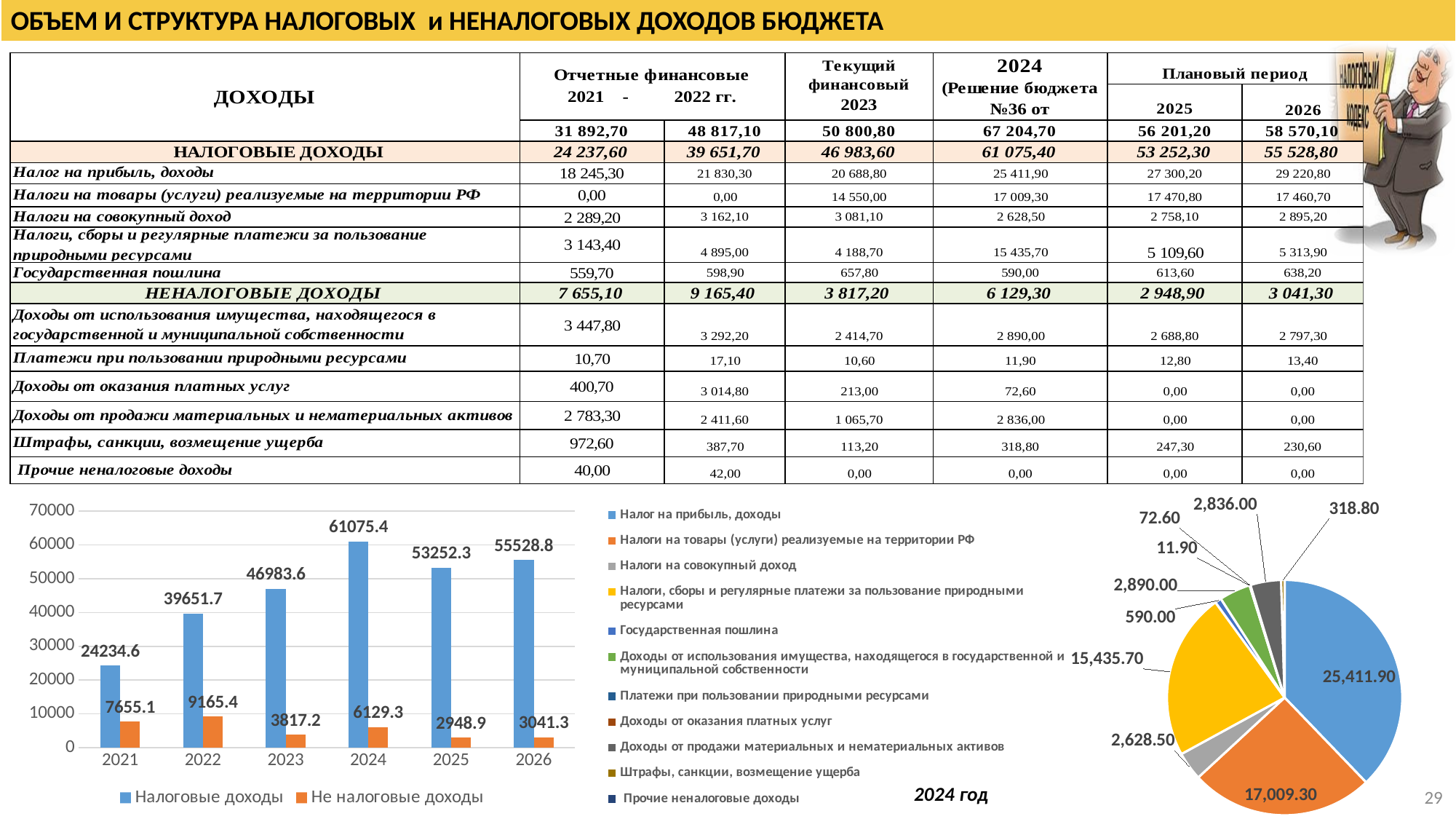
In the pie chart at the bottom right, what is the value of the largest slice? 25,411.90 How many years are shown on the x axis of the bar chart at the bottom left? 6 How many series does the legend of the bar chart at the bottom left list? 2 In the bar chart at the bottom left, what is the value of Не налоговые доходы for 2023? 3817.2 In the bar chart at the bottom left, what is the difference between Налоговые доходы and Не налоговые доходы in 2024? 54946.1 In the pie chart at the bottom right, what is the difference between the two largest slices, 25,411.90 and 17,009.30? 8,402.60 In the bar chart at the bottom left, which year has the highest value of Налоговые доходы? 2024 What kind of chart is the chart at the bottom left of the slide? bar chart In the bar chart at the bottom left, what is the value of Налоговые доходы for 2024? 61075.4 In the bar chart at the bottom left, do the values of Налоговые доходы rise or fall from 2021 to 2024? rise In the bar chart at the bottom left, which year has the larger value of Налоговые доходы, 2025 or 2026? 2026 In the bar chart at the bottom left, which year has the lowest value of Не налоговые доходы? 2025